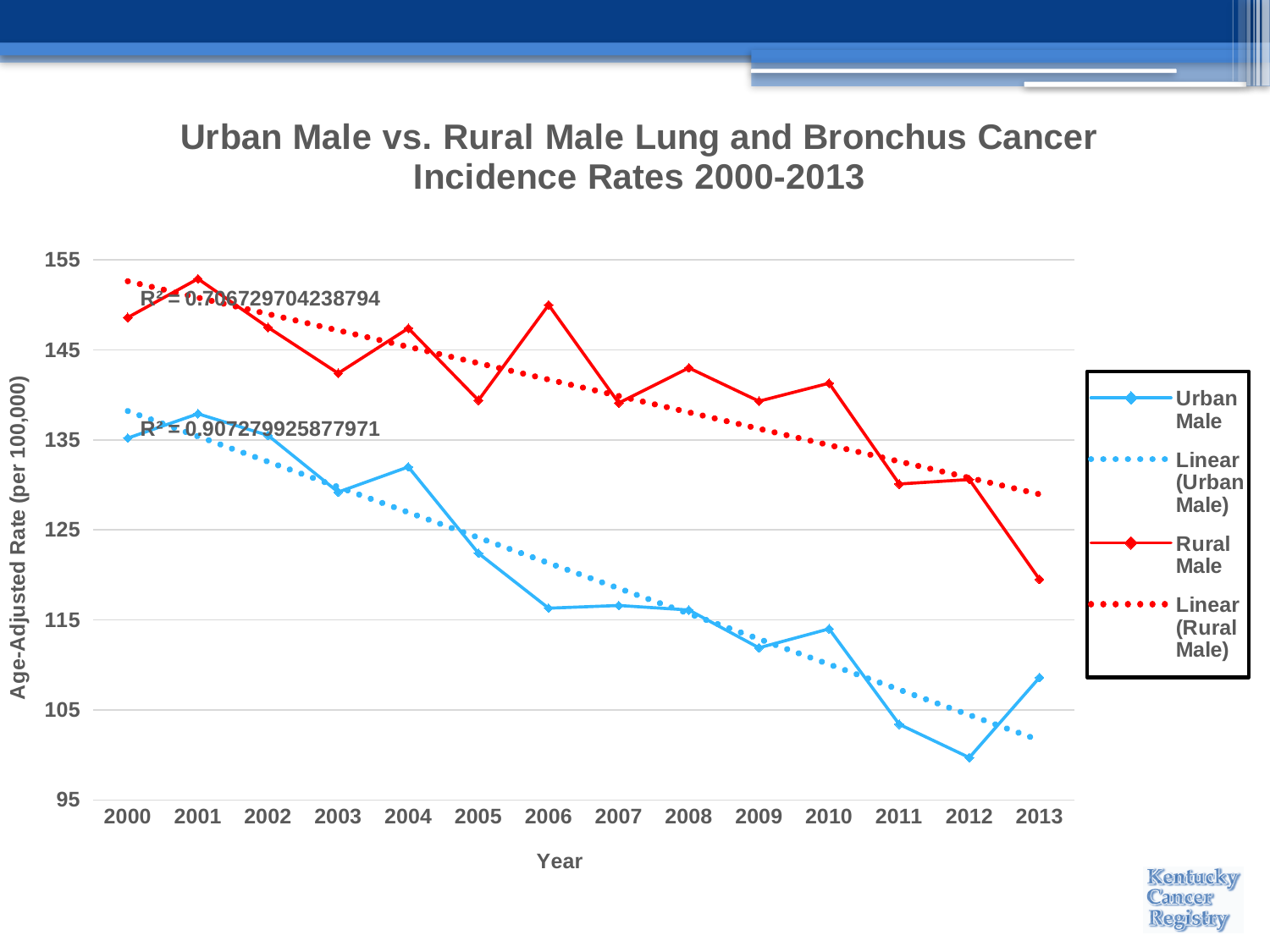
How many years are plotted along the x axis? 14 What kind of chart is shown on the slide? Line chart In 2013, which series has the higher incidence rate, Urban Male or Rural Male? Rural Male Do the Urban Male incidence rates generally rise or fall from 2000 to 2013? Fall Is the Urban Male value for 2004 greater or less than 125? greater In which year is the Urban Male incidence rate lowest? 2012 How many entries does the legend list? 4 Is the Rural Male value for 2001 greater or less than 145? greater What R² value is shown for the Urban Male linear trendline? R² = 0.907279925877971 Is the Urban Male value for 2012 greater or less than 105? less In which year is the Rural Male incidence rate highest? 2001